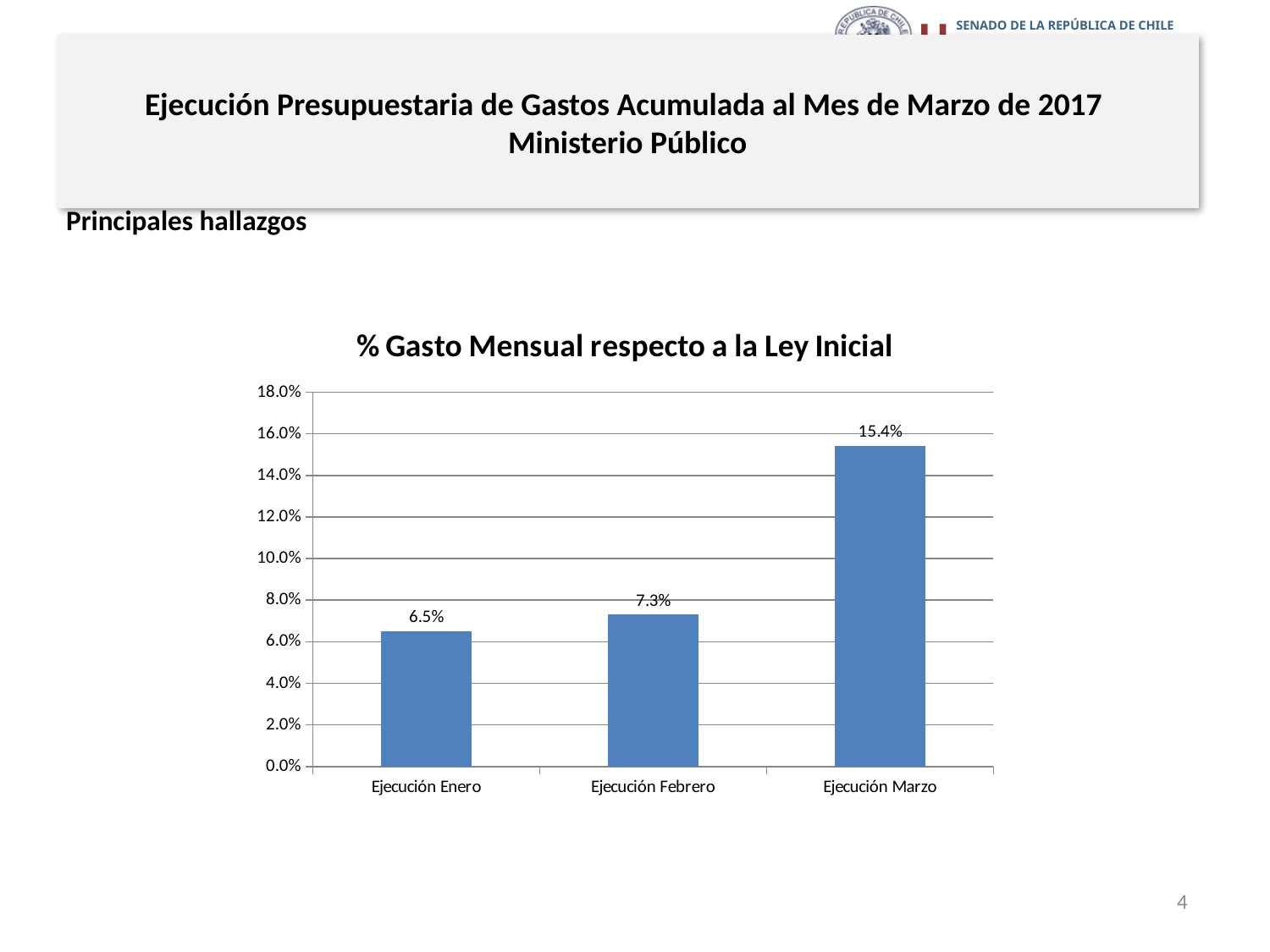
What is the difference between the values for Ejecución Marzo and Ejecución Febrero? 8.1% How many categories are shown on the x axis? 3 Which category has the lowest value? Ejecución Enero What kind of chart is shown on the slide? bar chart Which is larger, the value for Ejecución Marzo or Ejecución Enero? Ejecución Marzo Is the value for Ejecución Marzo greater or less than 14.0%? greater What is the difference between the values for Ejecución Febrero and Ejecución Enero? 0.8% What is the value for Ejecución Febrero? 7.3% What is the title of the chart? % Gasto Mensual respecto a la Ley Inicial Which category has the highest value? Ejecución Marzo What is the value for Ejecución Enero? 6.5% What is the value for Ejecución Marzo? 15.4%